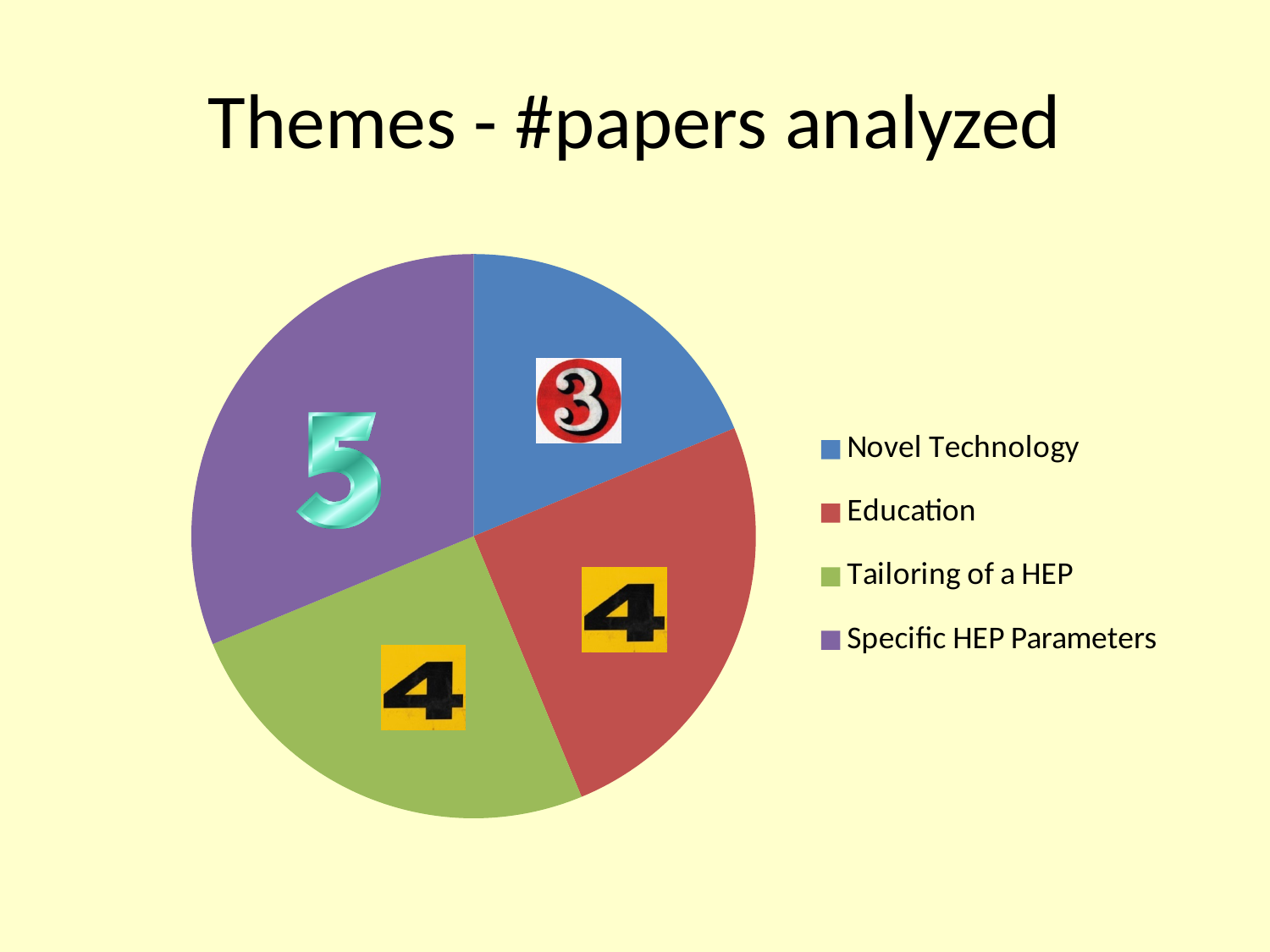
How many papers were analyzed under the Novel Technology theme? 3 Which colour represents Tailoring of a HEP in the pie chart? green How many more papers were analyzed for Specific HEP Parameters than for Novel Technology? 2 What type of chart is shown on the slide? pie chart How many papers were analyzed under the Specific HEP Parameters theme? 5 Which theme has the smallest number of papers analyzed? Novel Technology How many papers were analyzed under the Education theme? 4 What is the total number of papers analyzed across all four themes? 16 Which has more papers analyzed, Education or Novel Technology? Education How many themes (slices) does the pie chart show? 4 Which theme has the largest number of papers analyzed? Specific HEP Parameters What is the title of the chart? Themes - #papers analyzed